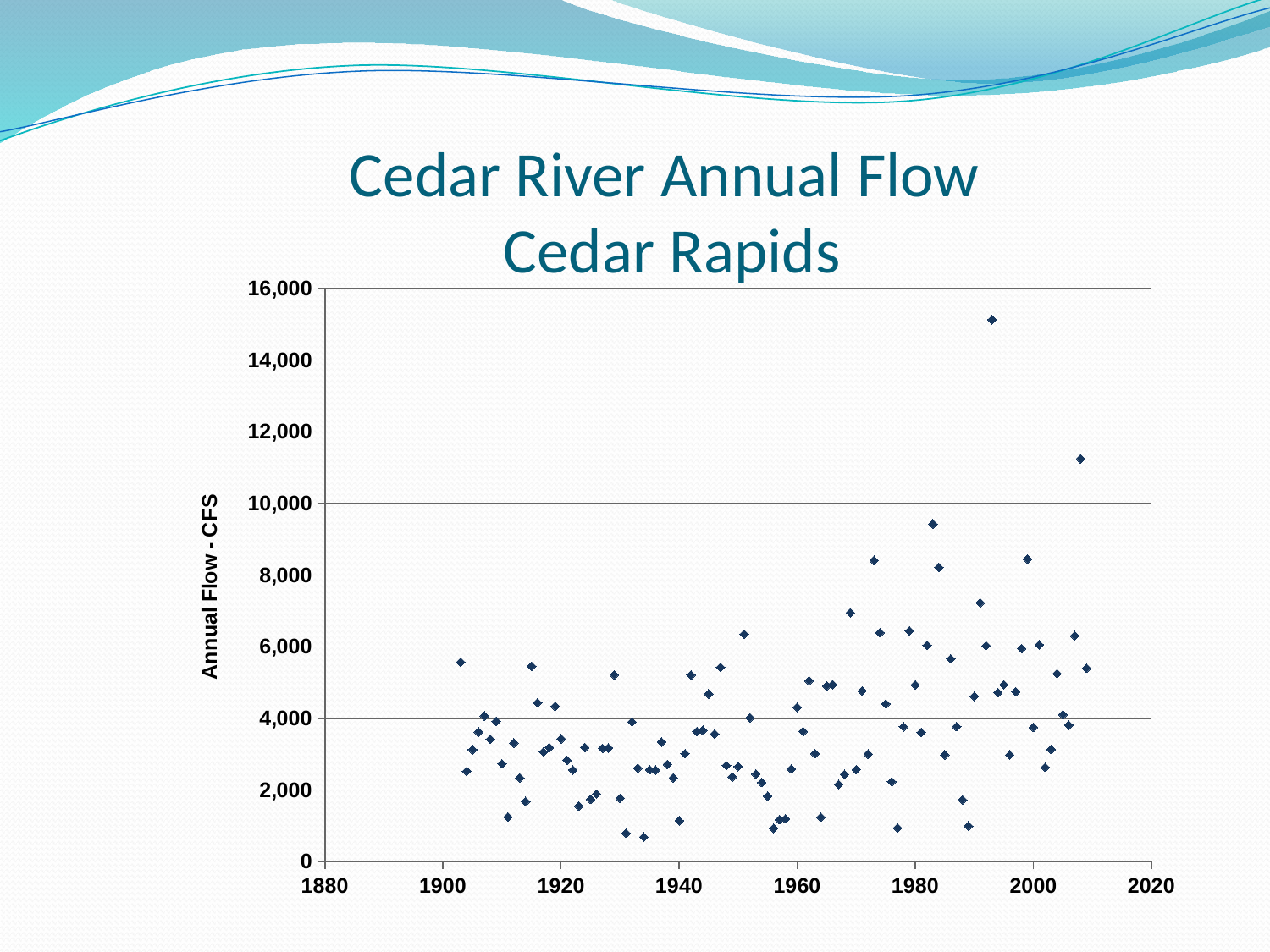
Do the highest annual flow values on the chart tend to rise or fall as the years move from 1900 toward 2010? rise Which period has more points above 8,000: before 1960 or after 1960? after 1960 How many points on the chart are above 12,000? 1 What is the maximum value shown on the vertical axis? 16,000 What kind of chart is shown on the slide? Scatter chart Is the second-highest point on the chart, near 2008, greater or less than 10,000? greater What is the label on the vertical axis of the chart? Annual Flow - CFS What is the title of the chart? Cedar River Annual Flow Cedar Rapids In which decade does the highest annual flow value on the chart occur? 1990s Is the highest point on the chart greater or less than 14,000? greater Is the lowest point on the chart greater or less than 1,000? less